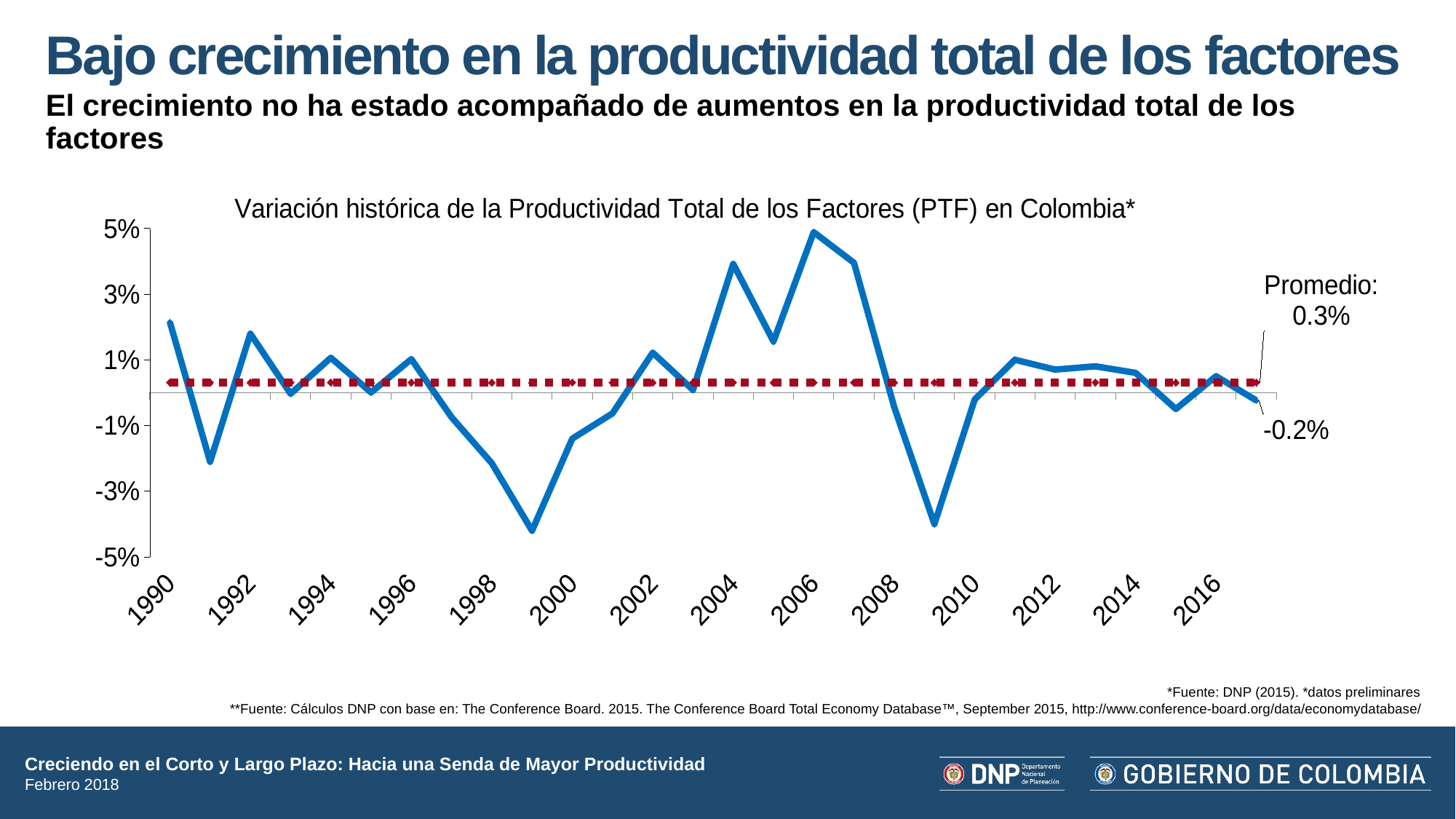
What is the average (Promedio) value shown on the chart? 0.3% Between 2006 and 2009, does the blue line rise or fall? fall What colour is the dashed horizontal line representing the average? red What is the value labeled at the end of the blue line? -0.2% Is the value for 1998 greater or less than -1%? less Which is larger, the value for 2004 or the value for 2002? 2004 What kind of chart is shown on the slide? line chart Which labeled year has the highest value on the blue line? 2006 How many year labels are shown on the x axis? 14 What is the title of the chart? Variación histórica de la Productividad Total de los Factores (PTF) en Colombia* Is the value for 1990 greater or less than 1%? greater Is the value for 2006 greater or less than 3%? greater